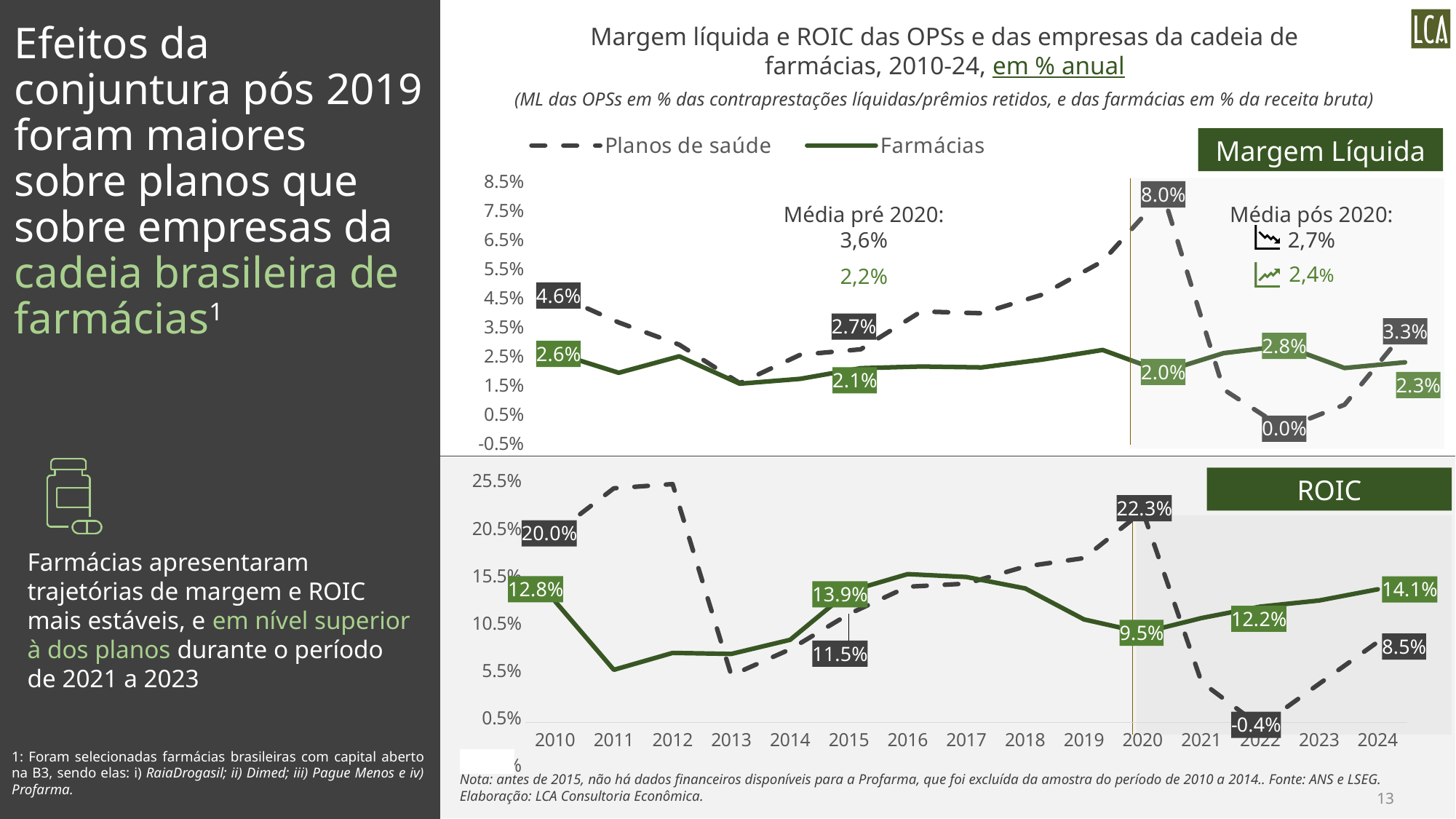
In the Margem Líquida chart, what is the value for Planos de saúde in 2020? 8.0% In the ROIC chart, which series has the larger value in 2015, Planos de saúde or Farmácias? Farmácias In the Margem Líquida chart, what is the value for Farmácias in 2022? 2.8% In the ROIC chart, what is the value for Farmácias in 2024? 14.1% What kind of chart is the ROIC chart? Line chart In the ROIC chart, what is the difference between the Planos de saúde and Farmácias values in 2020? 12.8% In the Margem Líquida chart, what is the value for Planos de saúde in 2022? 0.0% How many series does the legend list for the charts? 2 In the ROIC chart, is the value for Planos de saúde in 2011 greater or less than 20.5%? greater In the Margem Líquida chart, what is the difference between the Planos de saúde and Farmácias values in 2010? 2.0% In the Margem Líquida chart, which series has the larger value in 2024, Planos de saúde or Farmácias? Planos de saúde In the ROIC chart, what is the value for Planos de saúde in 2022? -0.4%